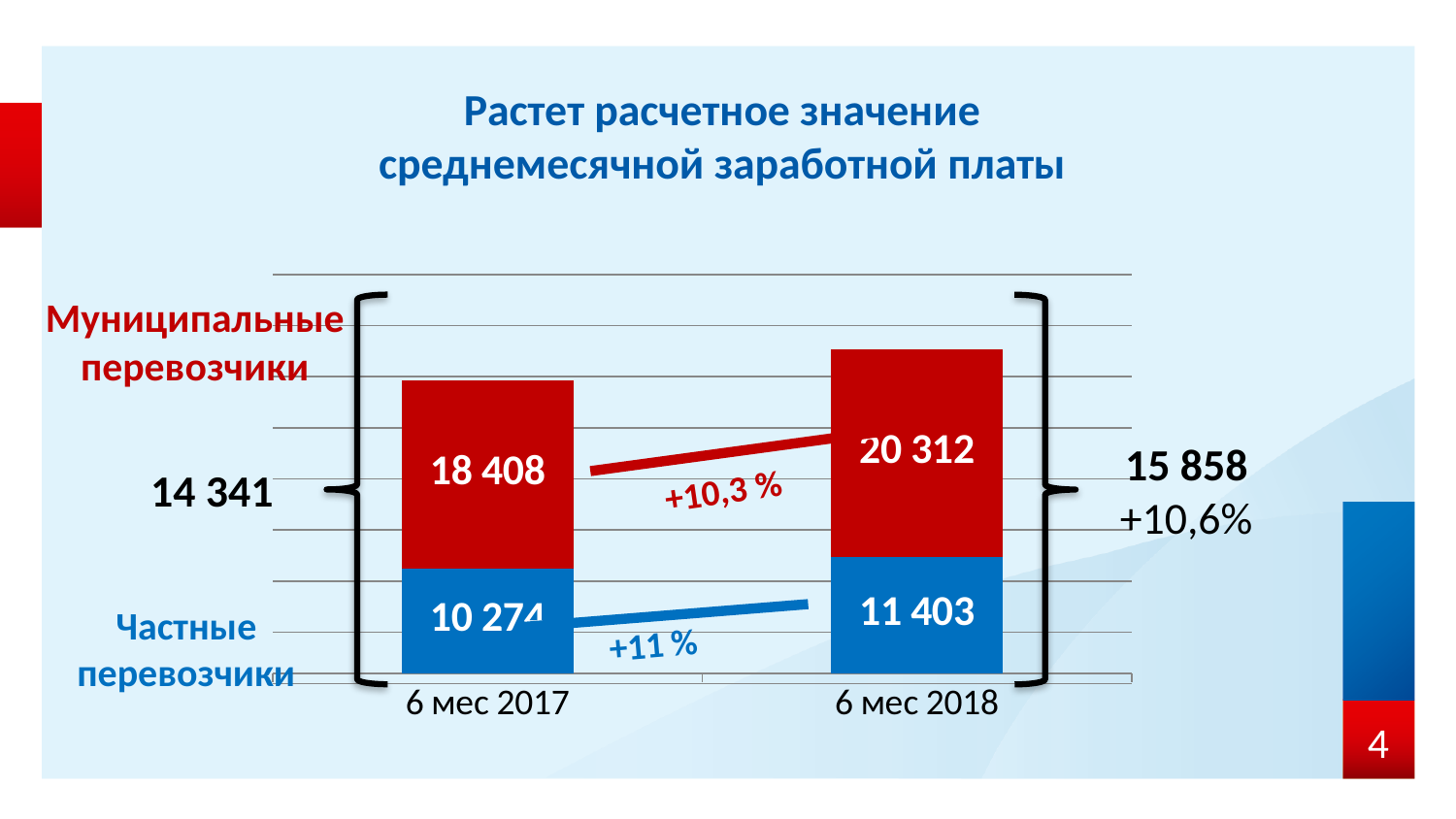
By how much did the value for Частные перевозчики increase from 6 мес 2017 to 6 мес 2018? 1 129 How many time periods are shown on the x axis of the chart? 2 What is the value for Муниципальные перевозчики in 6 мес 2017? 18 408 What is the value for Муниципальные перевозчики in 6 мес 2018? 20 312 By how much did the value for Муниципальные перевозчики increase from 6 мес 2017 to 6 мес 2018? 1 904 What percentage growth is shown for Частные перевозчики between 6 мес 2017 and 6 мес 2018? +11 % What is the value for Частные перевозчики in 6 мес 2018? 11 403 What kind of chart is shown on the slide? Stacked bar chart What percentage growth is shown for Муниципальные перевозчики between 6 мес 2017 and 6 мес 2018? +10,3 % Do the values for Частные перевозчики rise or fall from 6 мес 2017 to 6 мес 2018? Rise Which is larger in 6 мес 2018: the value for Муниципальные перевозчики or for Частные перевозчики? Муниципальные перевозчики What is the value for Частные перевозчики in 6 мес 2017? 10 274